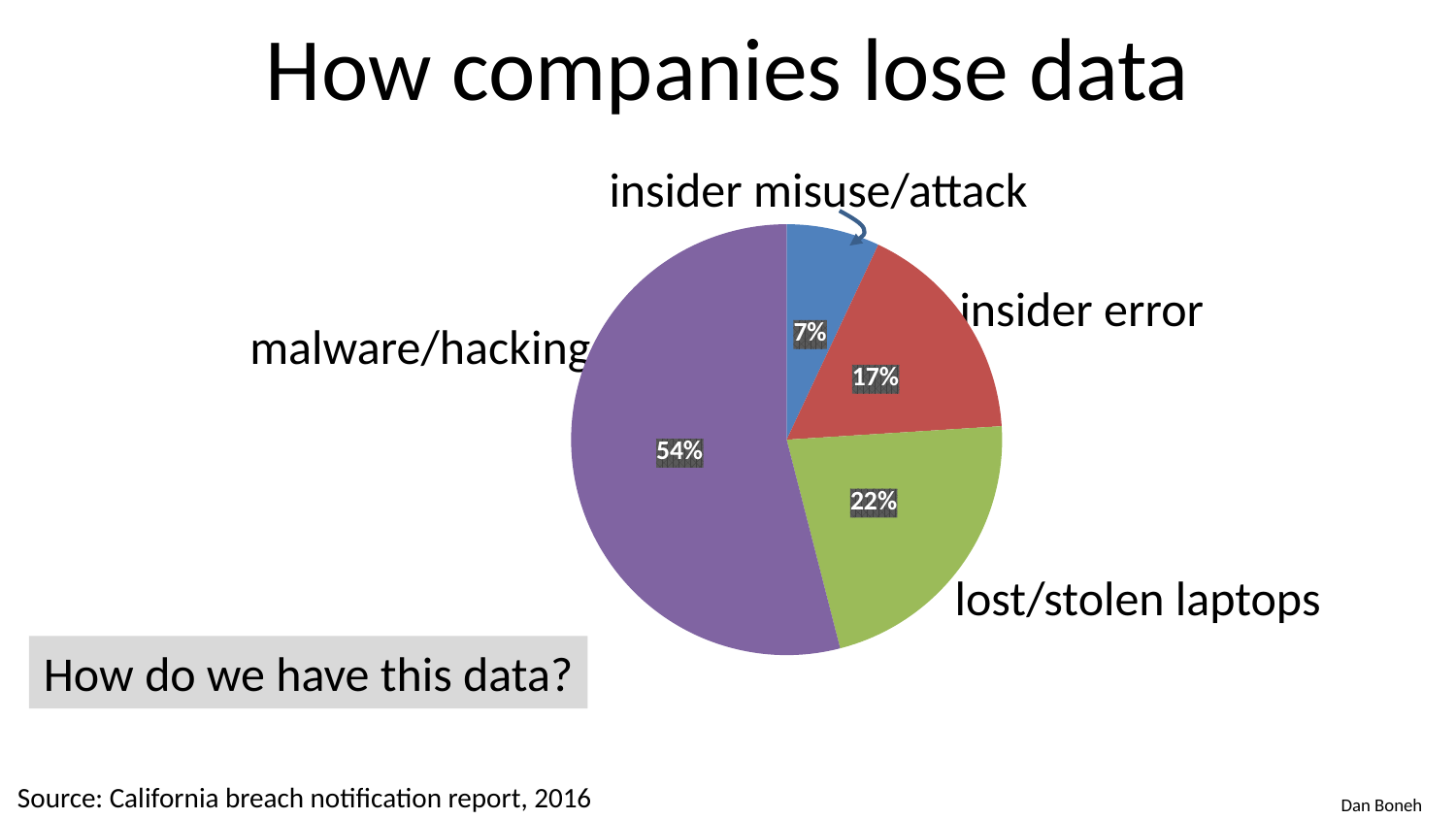
Which category has the smallest share of the pie? insider misuse/attack What colour is the malware/hacking slice? purple Which category has the largest share of the pie? malware/hacking How many slices does the pie chart have? 4 What share of the pie is insider error? 17% What is the difference in percentage points between malware/hacking and lost/stolen laptops? 32 What is the title of the chart? How companies lose data What share of the pie is insider misuse/attack? 7% What share of the pie is malware/hacking? 54% What share of the pie is lost/stolen laptops? 22% Which is larger, insider error or lost/stolen laptops? lost/stolen laptops What kind of chart is shown on the slide? pie chart